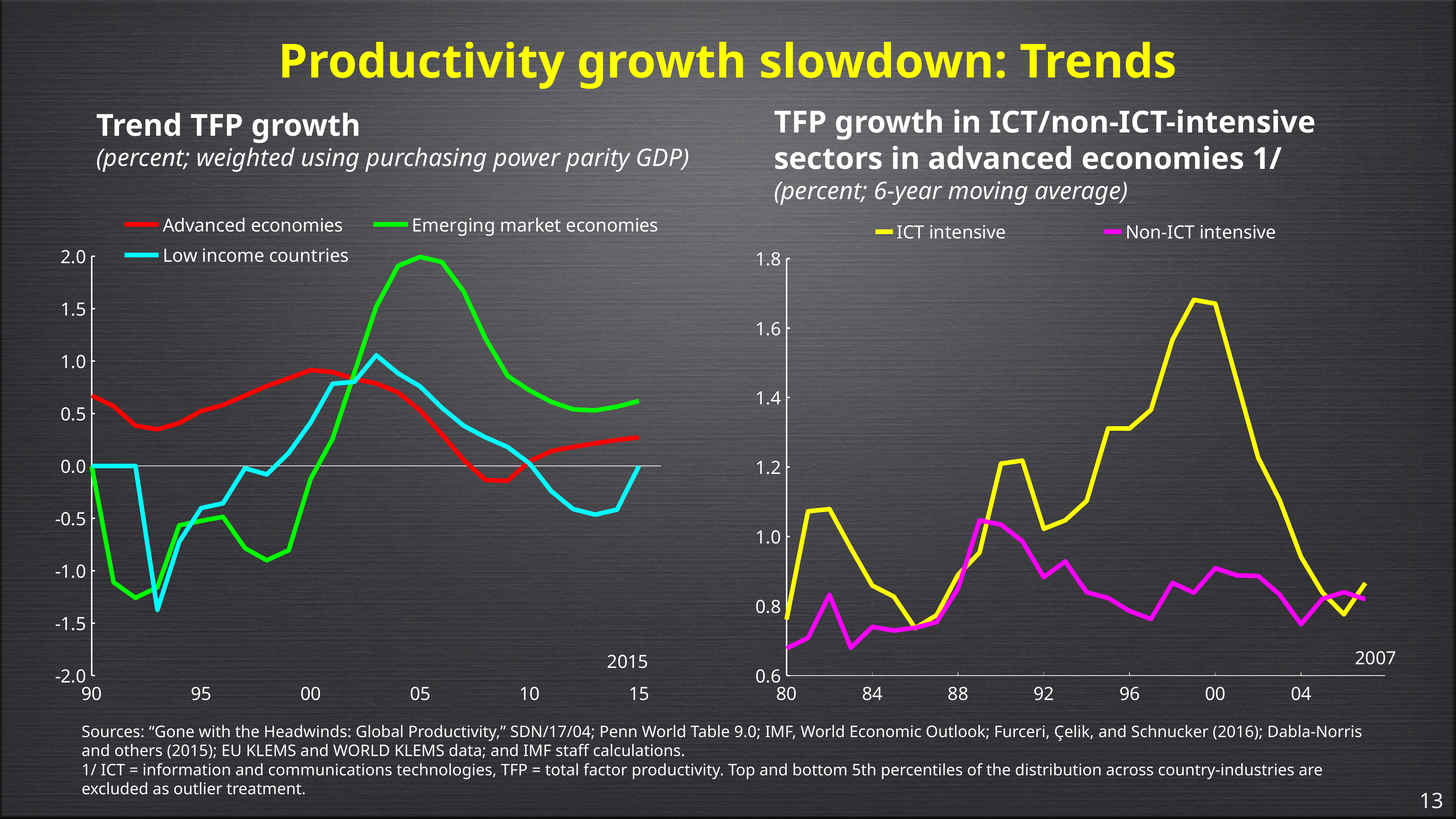
What kind of chart is the 'Trend TFP growth' chart? line chart In the 'TFP growth in ICT/non-ICT-intensive sectors' chart, is the value for Non-ICT intensive in 1980 greater or less than 0.8? less In the 'Trend TFP growth' chart, which series reaches the highest value? Emerging market economies How many series does the legend of the 'Trend TFP growth' chart list? 3 In the 'TFP growth in ICT/non-ICT-intensive sectors' chart, is the peak value of ICT intensive greater or less than 1.6? greater In the 'Trend TFP growth' chart, is the value for Emerging market economies around 2005 greater or less than 1.5? greater In the 'TFP growth in ICT/non-ICT-intensive sectors' chart, which is larger around 1999: ICT intensive or Non-ICT intensive? ICT intensive In the 'Trend TFP growth' chart, does the Emerging market economies line rise or fall between 2005 and 2010? fall In the 'Trend TFP growth' chart, which is larger around 2005: Emerging market economies or Advanced economies? Emerging market economies How many series does the legend of the 'TFP growth in ICT/non-ICT-intensive sectors in advanced economies' chart list? 2 In the 'TFP growth in ICT/non-ICT-intensive sectors' chart, what colour is the ICT intensive line? yellow